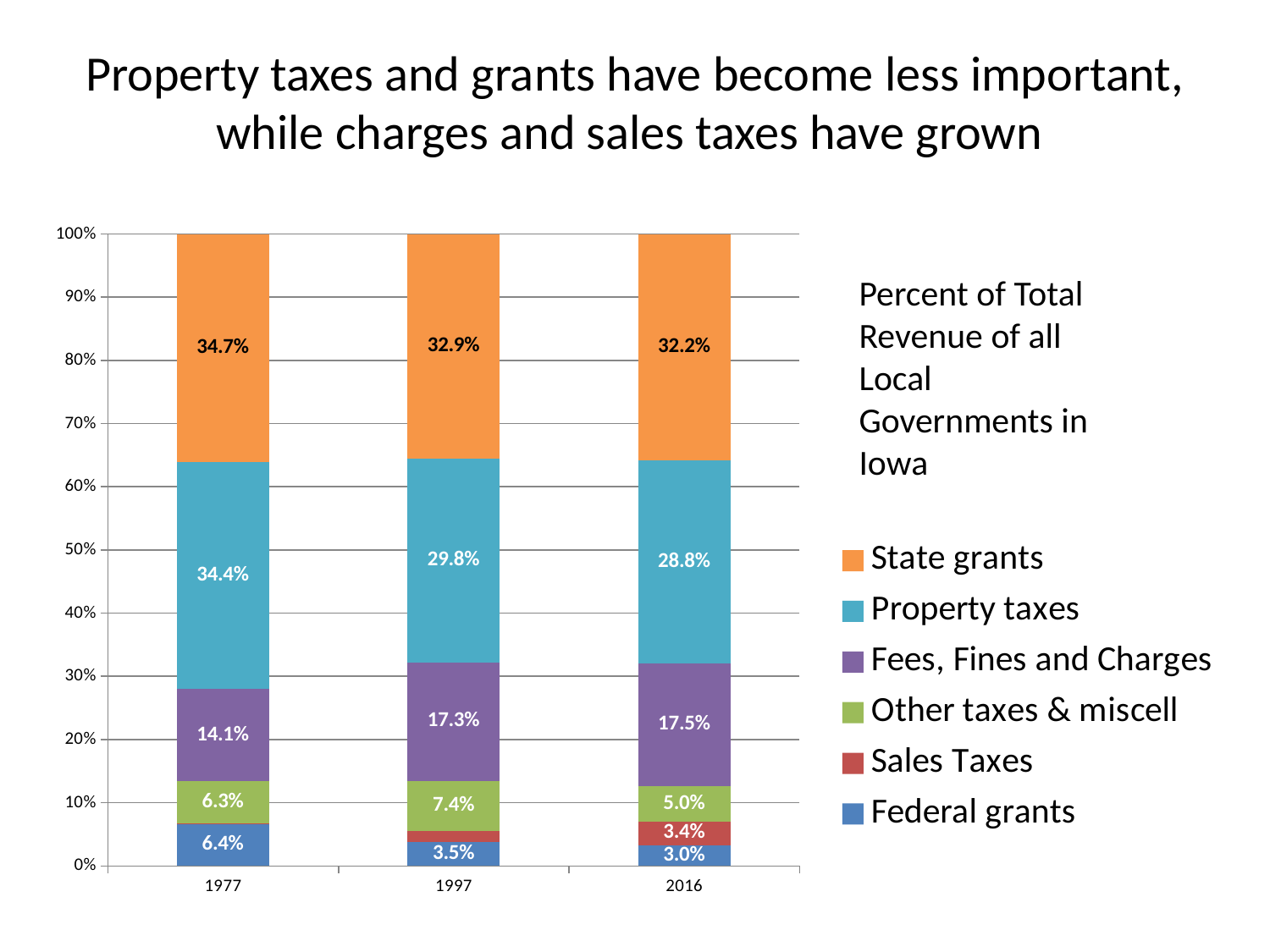
How many years are shown on the x axis of the chart? 3 Which was larger in 1997: the share of Other taxes & miscell or the share of Federal grants? Other taxes & miscell What share of total revenue did State grants make up in 1977? 34.7% How many series does the chart's legend list? 6 In which year was the Federal grants share the lowest? 2016 What share of total revenue did Fees, Fines and Charges make up in 1997? 17.3% What share of total revenue did Property taxes make up in 2016? 28.8% Does the share of Fees, Fines and Charges rise or fall from 1977 to 2016? rise What share of total revenue did Sales Taxes make up in 2016? 3.4% What kind of chart is shown on the slide? stacked bar chart By how many percentage points did the Property taxes share fall from 1977 to 2016? 5.6 percentage points In which year was the Property taxes share the highest? 1977